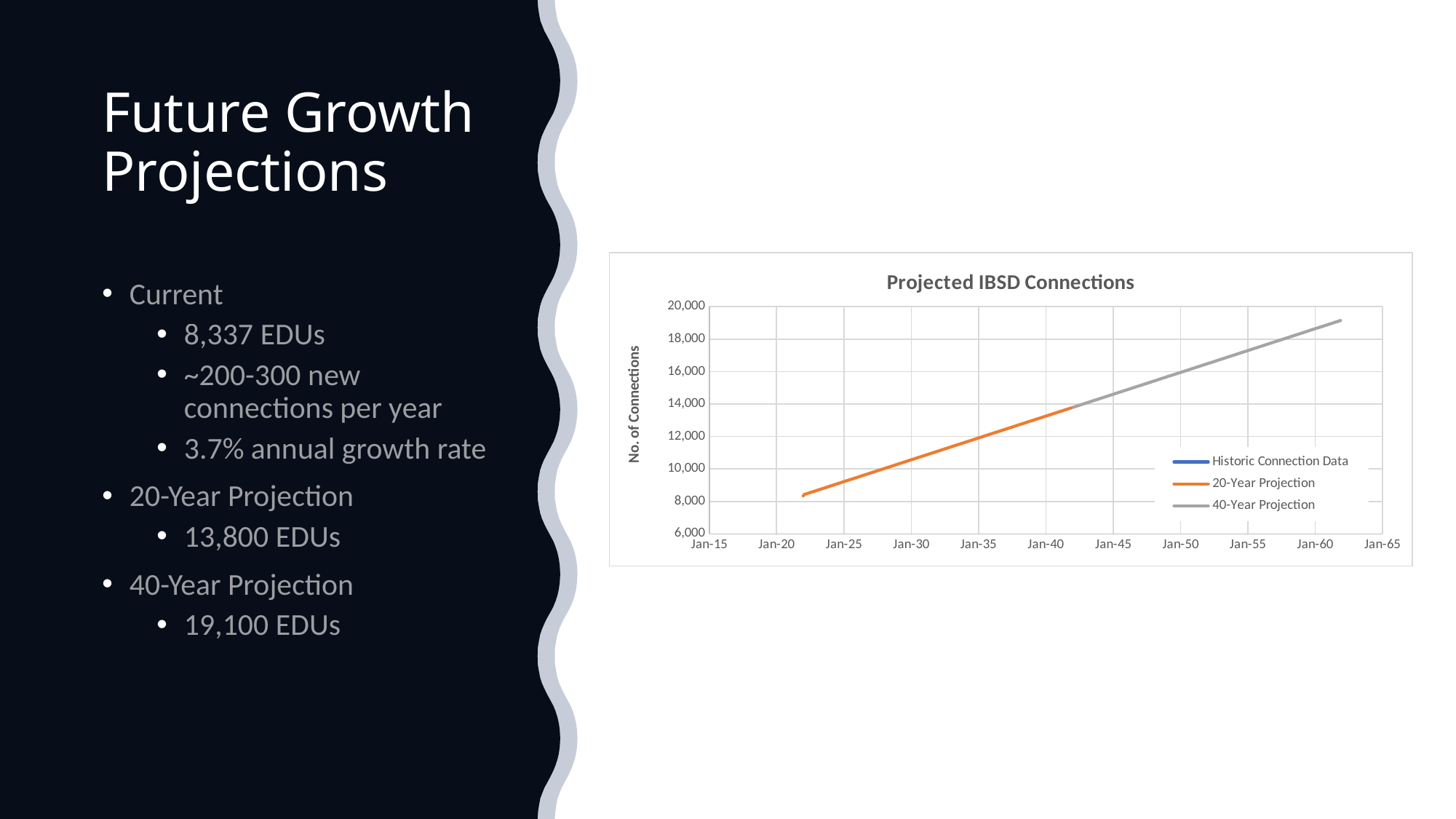
Is the value of the 40-Year Projection line at Jan-60 greater or less than 16,000? greater Is the value of the 40-Year Projection line at Jan-50 greater or less than 14,000? greater Which series reaches a higher value on the chart, the 20-Year Projection or the 40-Year Projection? 40-Year Projection What is the title of the chart? Projected IBSD Connections How many series does the chart legend list? 3 Is the value of the 40-Year Projection line at Jan-55 greater or less than 20,000? less Do the projected connections rise or fall over time along the x axis? rise What type of chart is shown on the slide? line chart What is the label on the vertical axis of the chart? No. of Connections